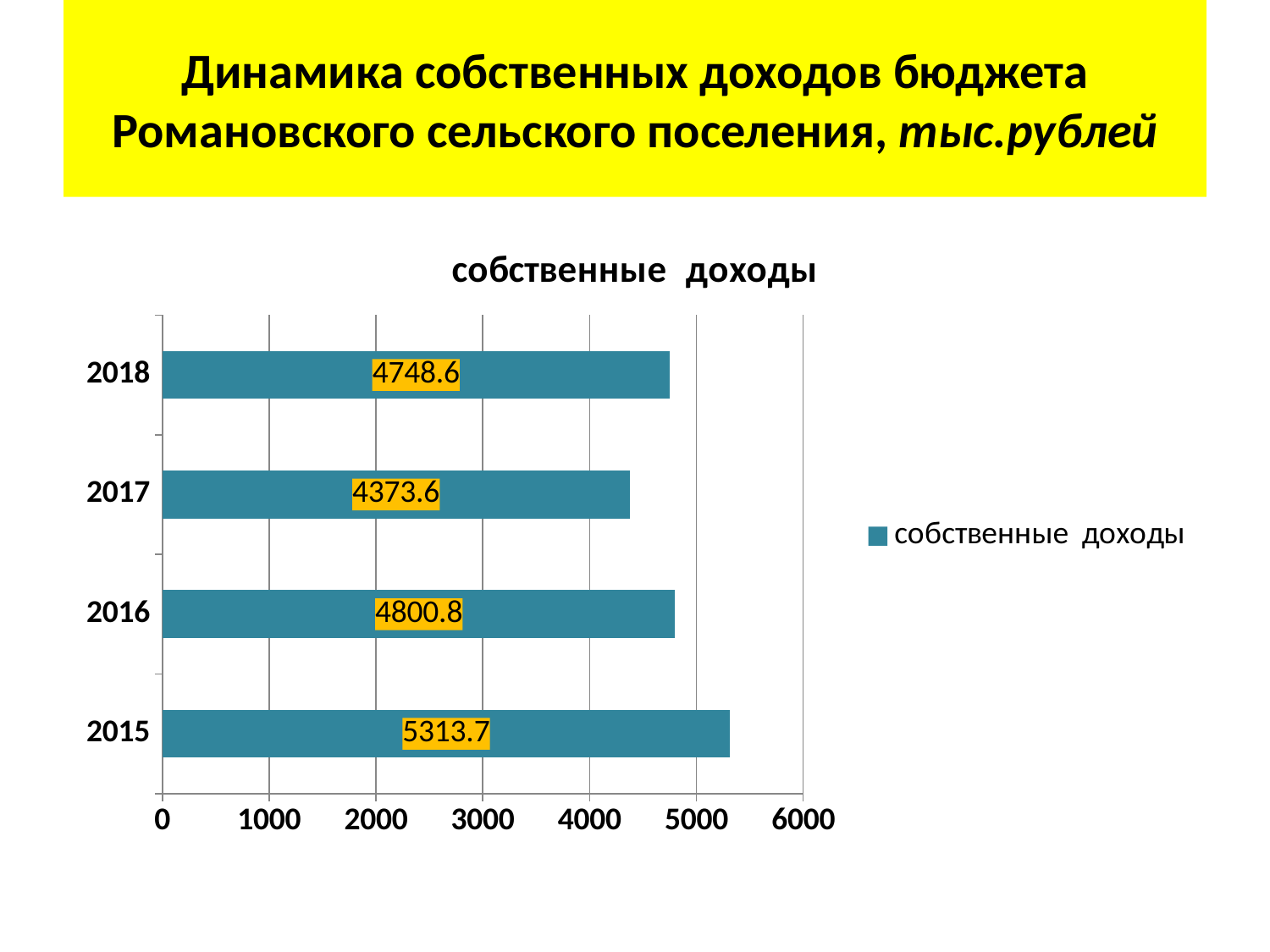
What kind of chart is shown on the slide? bar chart Is the value for 2015 greater or less than 5000? greater What is the difference between the values for 2018 and 2017? 375 What is the value for 2018 in the chart? 4748.6 What is the value for 2017 in the chart? 4373.6 Which year has the highest value in the chart? 2015 Which is larger, the value for 2016 or the value for 2017? 2016 What is the value for 2015 in the chart? 5313.7 Which year has the lowest value in the chart? 2017 Between 2015 and 2017, do the values rise or fall? fall What is the difference between the values for 2015 and 2016? 512.9 How many years are shown in the chart? 4